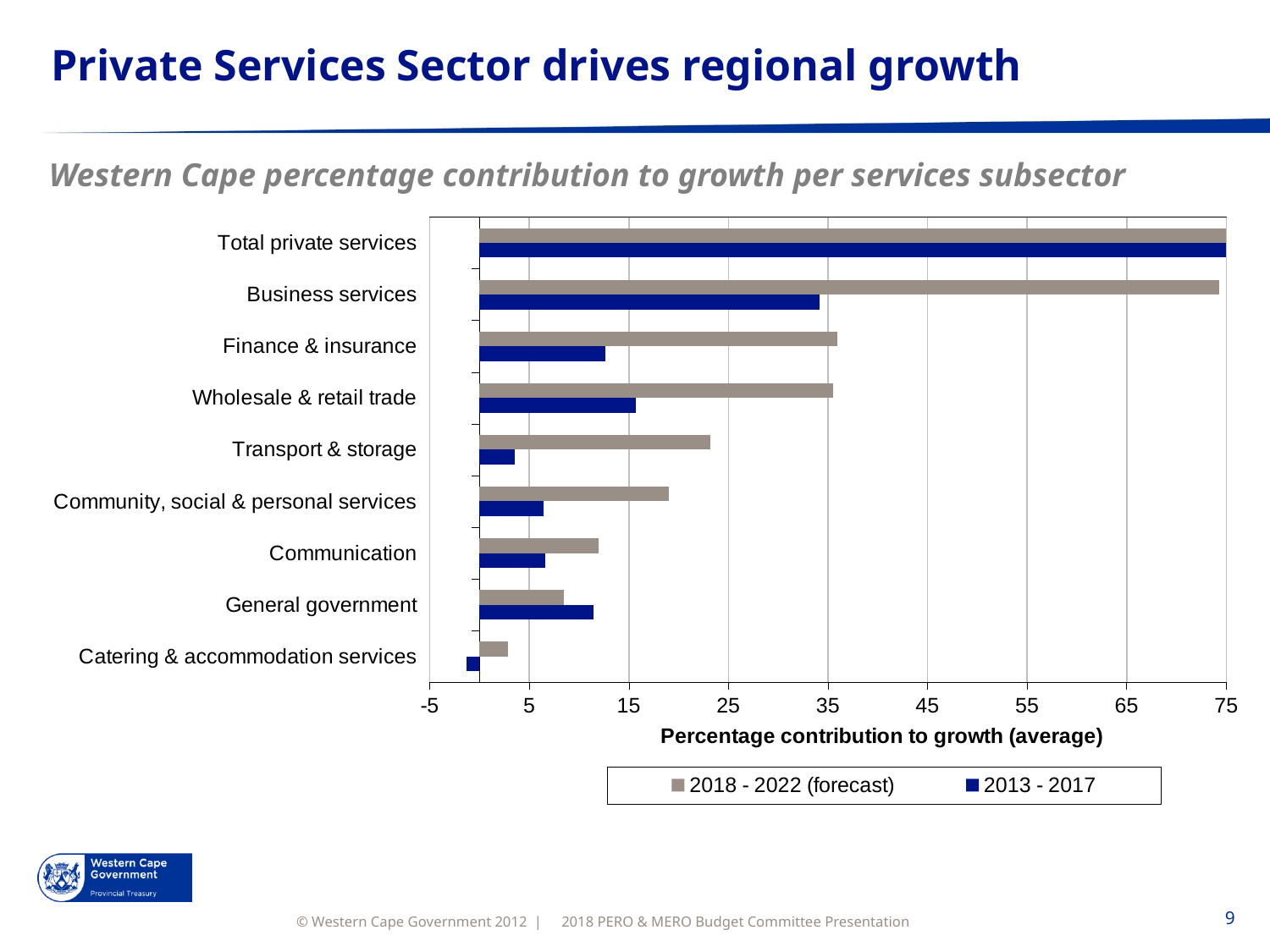
What kind of chart is shown on the slide? Bar chart For General government, which series has the larger value: 2018 - 2022 (forecast) or 2013 - 2017? 2013 - 2017 Is the 2013 - 2017 value for Transport & storage greater or less than 5? less Which category has the lowest 2013 - 2017 value? Catering & accommodation services Is the 2018 - 2022 (forecast) value for Community, social & personal services greater or less than 15? greater Is the 2018 - 2022 (forecast) value for Business services greater or less than 65? greater How many services subsectors (categories) are plotted on the chart? 9 Which category has the highest 2018 - 2022 (forecast) value? Total private services What is the title of the horizontal axis? Percentage contribution to growth (average) For Business services, which series has the larger value: 2018 - 2022 (forecast) or 2013 - 2017? 2018 - 2022 (forecast) How many series does the legend list? 2